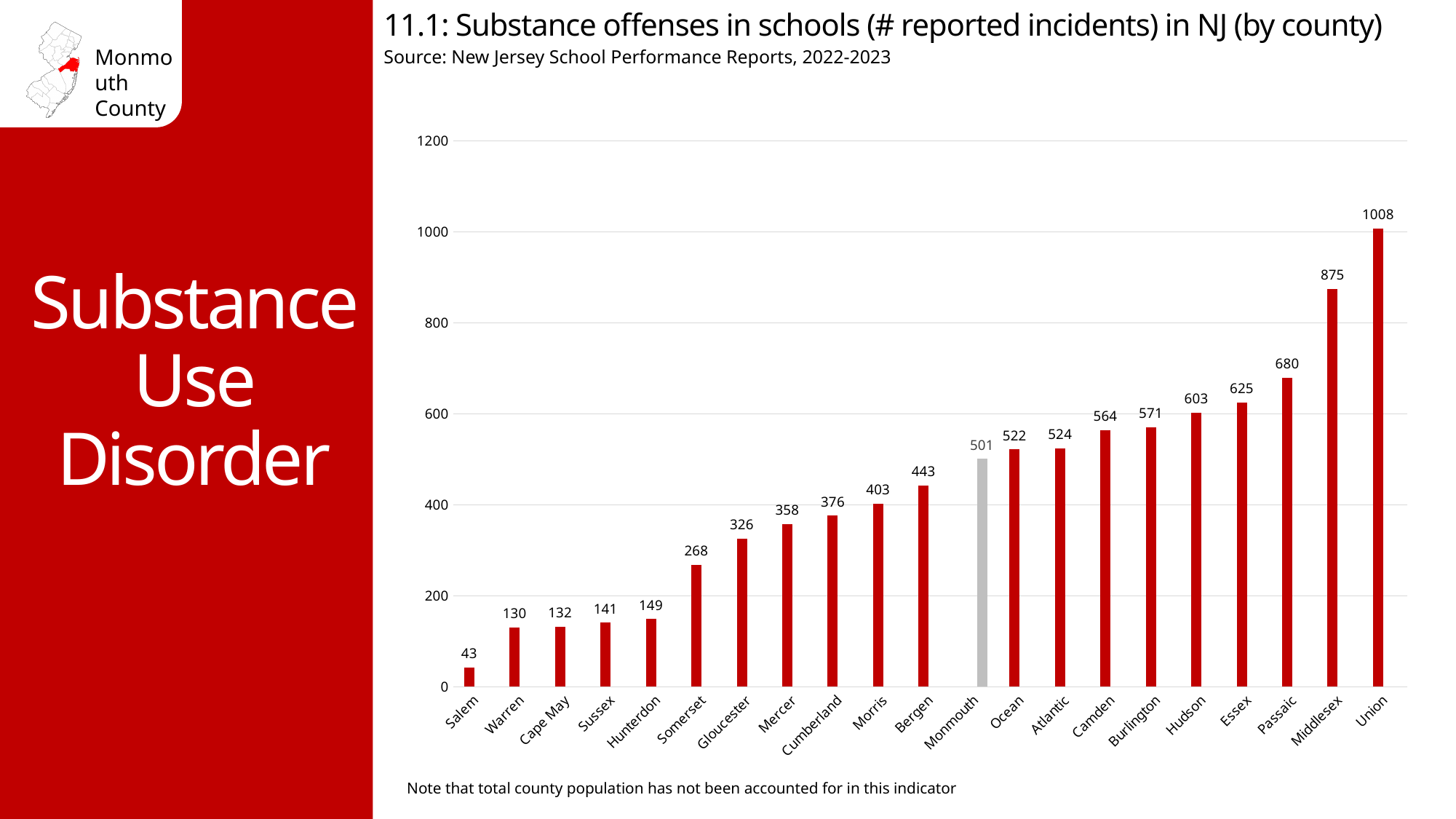
How many counties are shown on the chart? 21 What is the number of reported substance offense incidents in schools for Monmouth County? 501 What is the difference between the values for Monmouth and Salem? 458 Do the values rise or fall moving from left to right along the x axis? Rise Which bar is shown in a different colour (grey) from the others? Monmouth Which county has the lowest number of reported incidents? Salem Is the value for Passaic greater or less than 600? greater Which county has a higher value, Camden or Ocean? Camden Which county has the highest number of reported incidents? Union What is the value shown for Bergen County? 443 What is the difference between the values for Union and Middlesex? 133 What kind of chart is shown on the slide? Bar chart